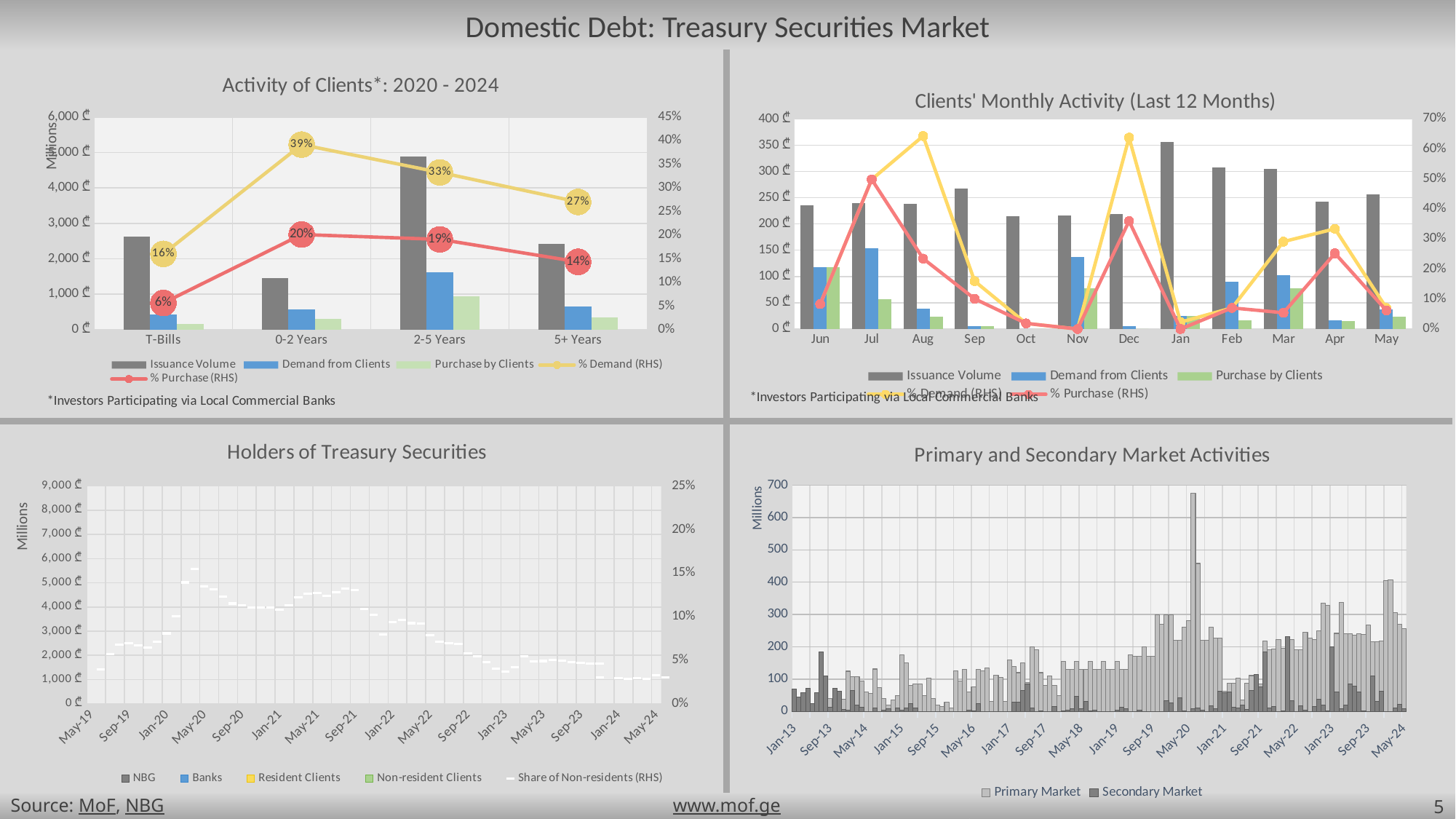
In the 'Activity of Clients*: 2020 - 2024' chart, which category has the lowest % Purchase? T-Bills How many series does the legend of the 'Primary and Secondary Market Activities' chart list? 2 In the 'Activity of Clients*: 2020 - 2024' chart, what is the % Purchase value for T-Bills? 6% In the 'Activity of Clients*: 2020 - 2024' chart, what is the difference between the % Demand and % Purchase values for 2-5 Years? 14% How many series does the legend of the 'Activity of Clients*: 2020 - 2024' chart list? 5 In the 'Clients' Monthly Activity (Last 12 Months)' chart, which month has the highest Issuance Volume? Jan In the 'Activity of Clients*: 2020 - 2024' chart, what is the % Demand value for 0-2 Years? 39% In the 'Activity of Clients*: 2020 - 2024' chart, which category has the highest % Demand? 0-2 Years What kind of chart is the 'Primary and Secondary Market Activities' chart? bar chart How many months are shown on the x axis of the 'Clients' Monthly Activity (Last 12 Months)' chart? 12 In the 'Activity of Clients*: 2020 - 2024' chart, is the % Purchase value for 5+ Years larger or smaller than the % Purchase value for 0-2 Years? smaller In the 'Clients' Monthly Activity (Last 12 Months)' chart, is the Issuance Volume for Jan greater or less than 300? greater